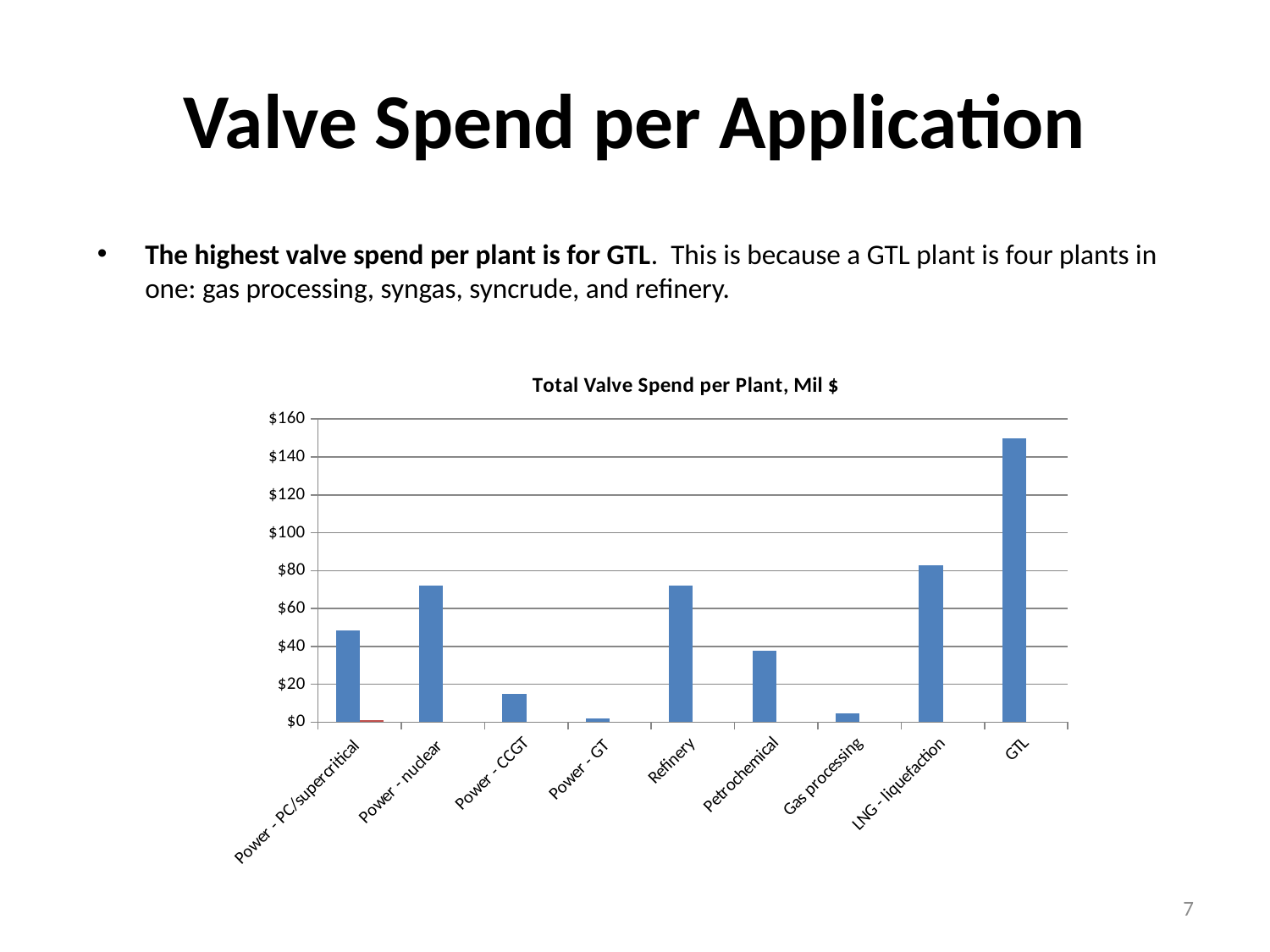
Which has a higher total valve spend per plant, Power - nuclear or Power - CCGT? Power - nuclear What kind of chart is shown on the slide? bar chart How many application categories are shown on the x axis of the chart? 9 Is the value for Petrochemical greater or less than $60? less Is the value for LNG - liquefaction greater or less than $60? greater Is the value for GTL greater or less than $140? greater Which application has the highest total valve spend per plant? GTL Which has a higher total valve spend per plant, Refinery or Petrochemical? Refinery Which application has the lowest total valve spend per plant? Power - GT Which has a higher total valve spend per plant, GTL or LNG - liquefaction? GTL What is the title of the chart? Total Valve Spend per Plant, Mil $